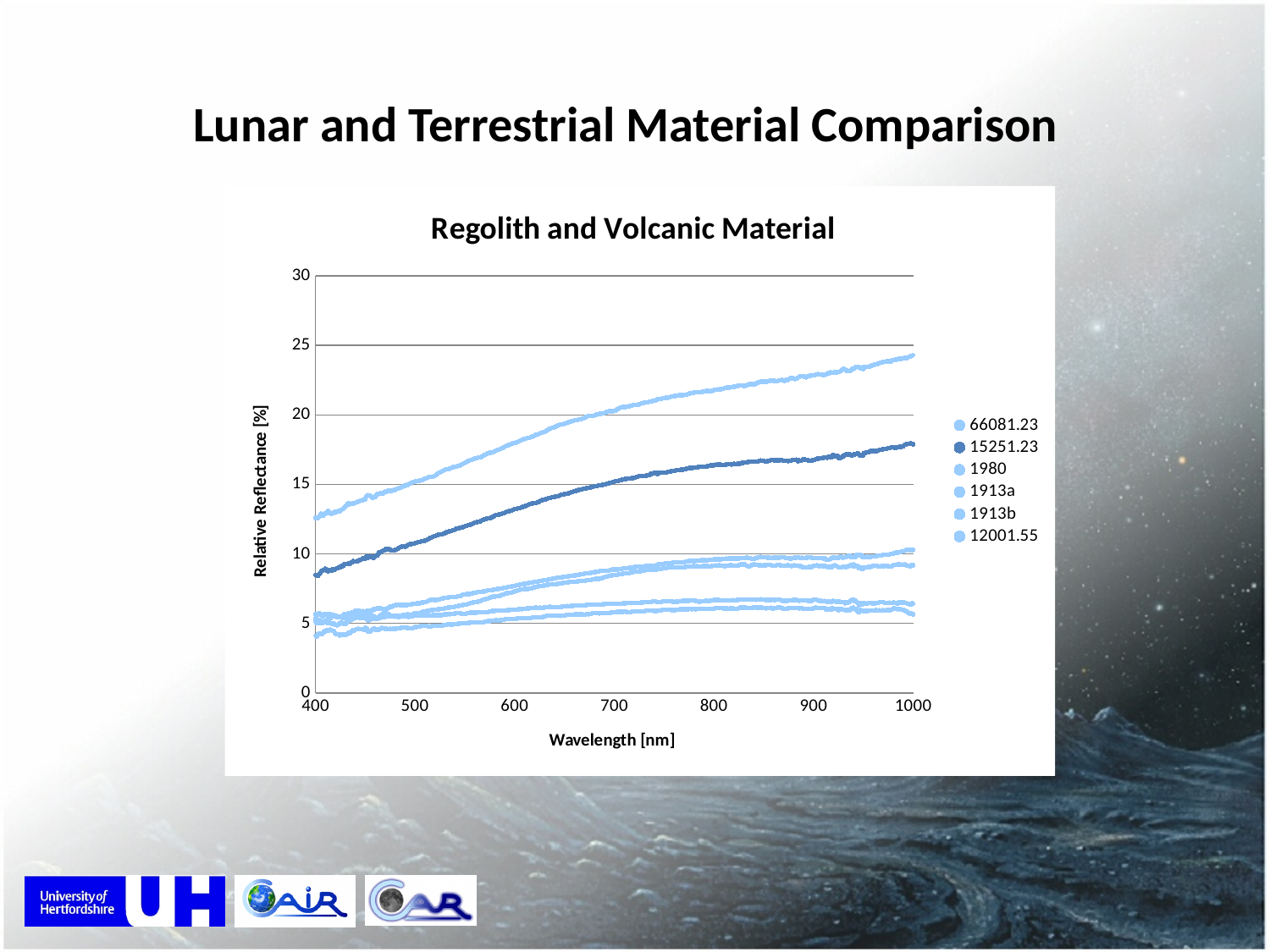
Is the value for 15251.23 at 1000 nm greater or less than 15? greater Is the value for 15251.23 at 400 nm greater or less than 10? less Is the highest series' value at 1000 nm greater or less than 20? greater What kind of chart is shown on the slide? line chart What is the title of the chart? Regolith and Volcanic Material How many series have a value below 10 at 400 nm? 5 What is the label of the vertical axis? Relative Reflectance [%] Does the highest series on the chart rise or fall as wavelength increases? rise Does the 15251.23 series rise or fall as wavelength increases from 400 to 1000 nm? rise How many series does the legend list? 6